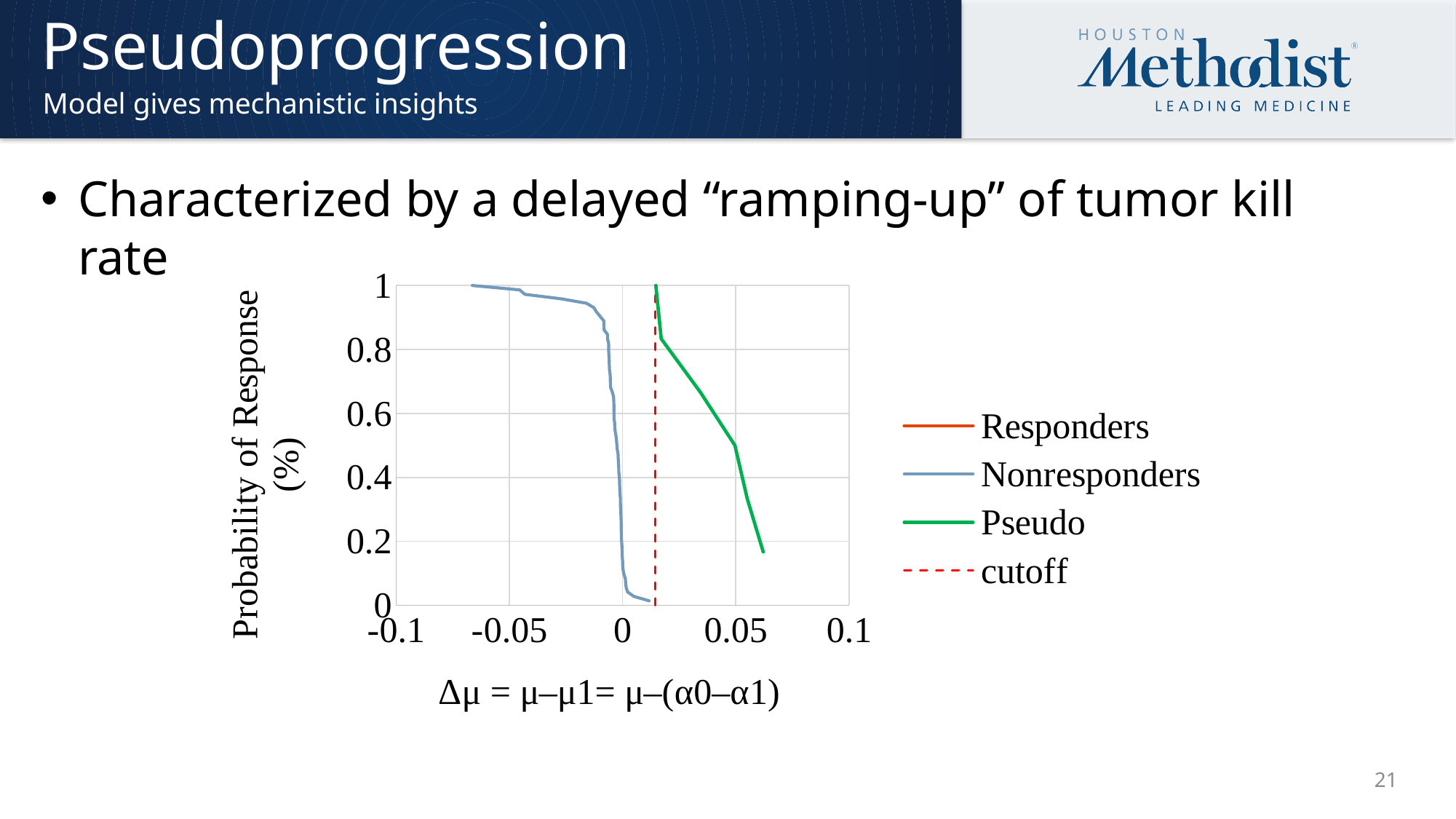
Is the cutoff line located at a Δμ greater or less than 0? greater Is the Nonresponders value at Δμ = -0.05 greater or less than 0.8? greater Which series lies to the right of the cutoff line: Nonresponders or Pseudo? Pseudo How many series does the legend list? 4 What is the label of the y axis? Probability of Response (%) Is the value at the rightmost end of the Pseudo line greater or less than 0.4? less Does the Nonresponders line rise or fall as Δμ increases? fall Does the Pseudo line rise or fall as Δμ increases? fall What are the series names listed in the legend? Responders, Nonresponders, Pseudo, cutoff What kind of chart is shown on the slide? line chart